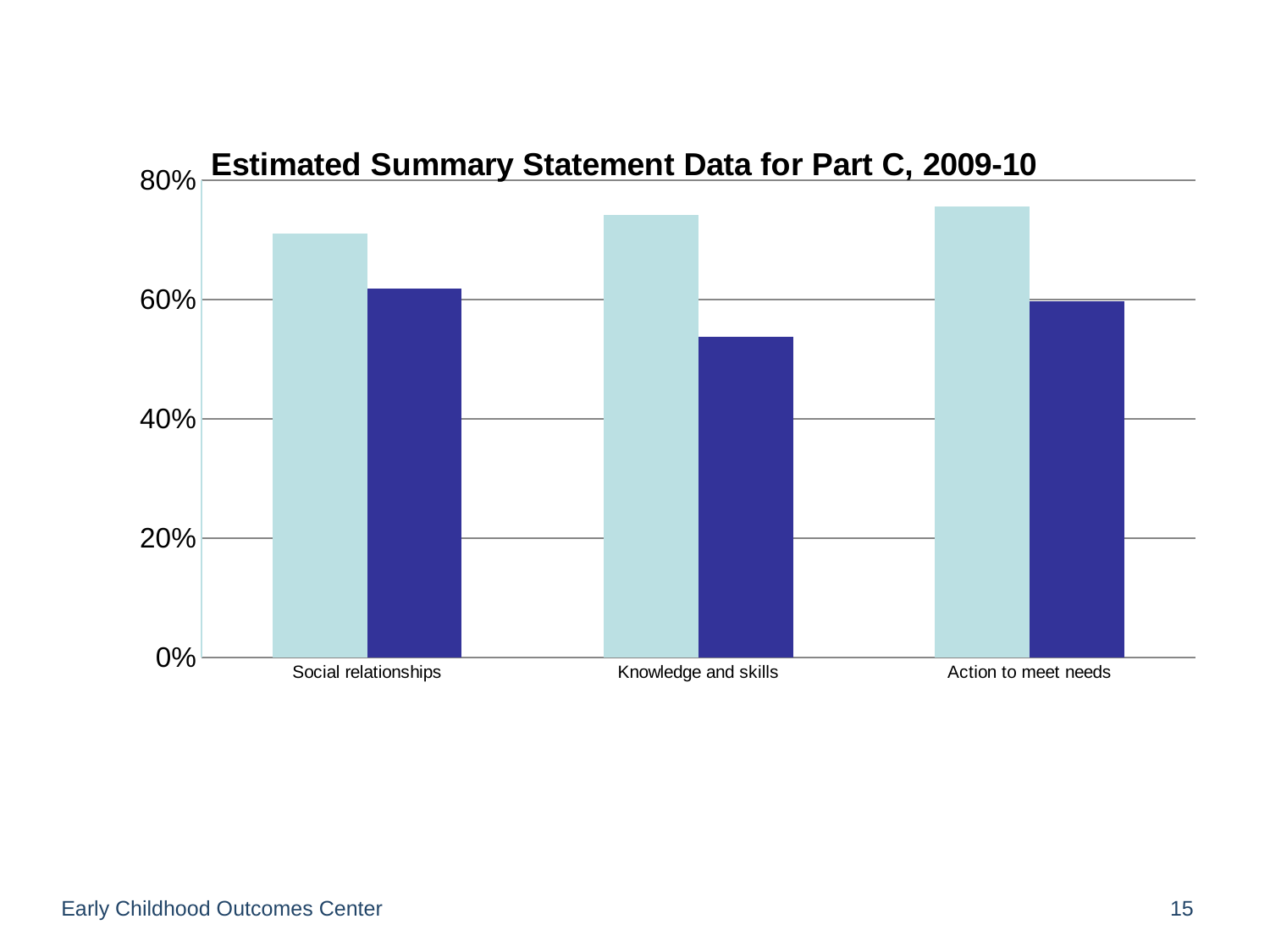
What is the title of the chart? Estimated Summary Statement Data for Part C, 2009-10 Is the value of the light blue bar for Action to meet needs greater or less than 80%? less Do the light blue bars rise or fall from left to right across the categories? rise Is the value of the light blue bar for Social relationships greater or less than 60%? greater How many categories are shown on the x axis of the chart? 3 What is the highest value shown on the y axis of the chart? 80% Among the dark blue bars, which category has the lowest value? Knowledge and skills Is the value of the dark blue bar for Knowledge and skills greater or less than 40%? greater How many bars are shown for each category in the chart? 2 For Knowledge and skills, which bar is taller, the light blue bar or the dark blue bar? the light blue bar What kind of chart is shown on the slide? bar chart